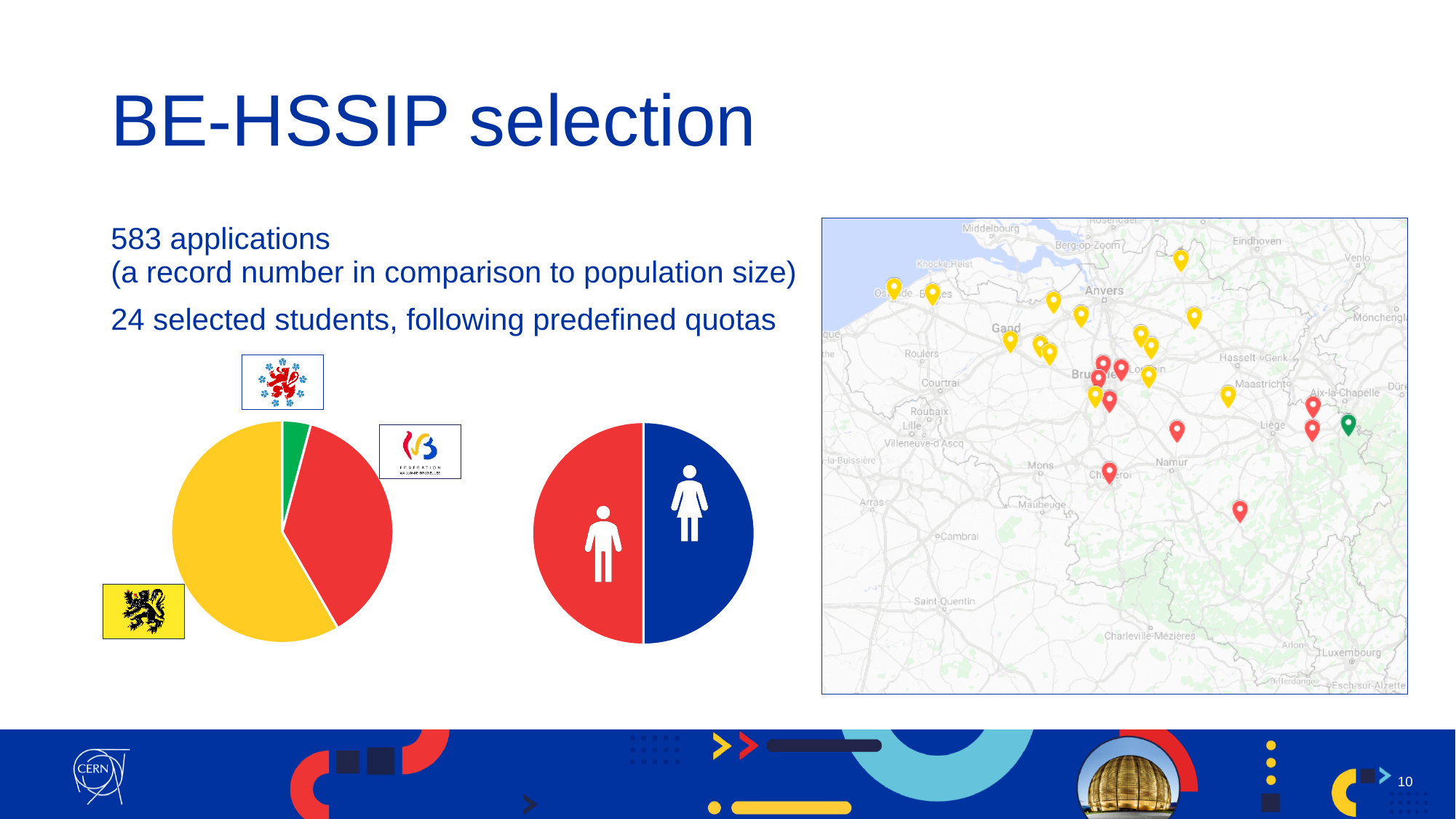
How many slices does the middle pie chart (with the male and female icons) have? 2 In the middle pie chart, what colour is the slice with the female icon? blue In the left pie chart (with the flags), which colour slice is the smallest? green What kind of chart is the left chart on the slide (the one with the flags)? pie chart In the left pie chart (with the flags), which is larger, the yellow slice or the red slice? yellow In the left pie chart (with the flags), which colour slice is the largest? yellow How many slices does the left pie chart (with the flags) have? 3 In the left pie chart (with the flags), which is larger, the red slice or the green slice? red How many pie charts are shown on the slide? 2 What kind of chart is the middle chart on the slide (the one with the male and female icons)? pie chart